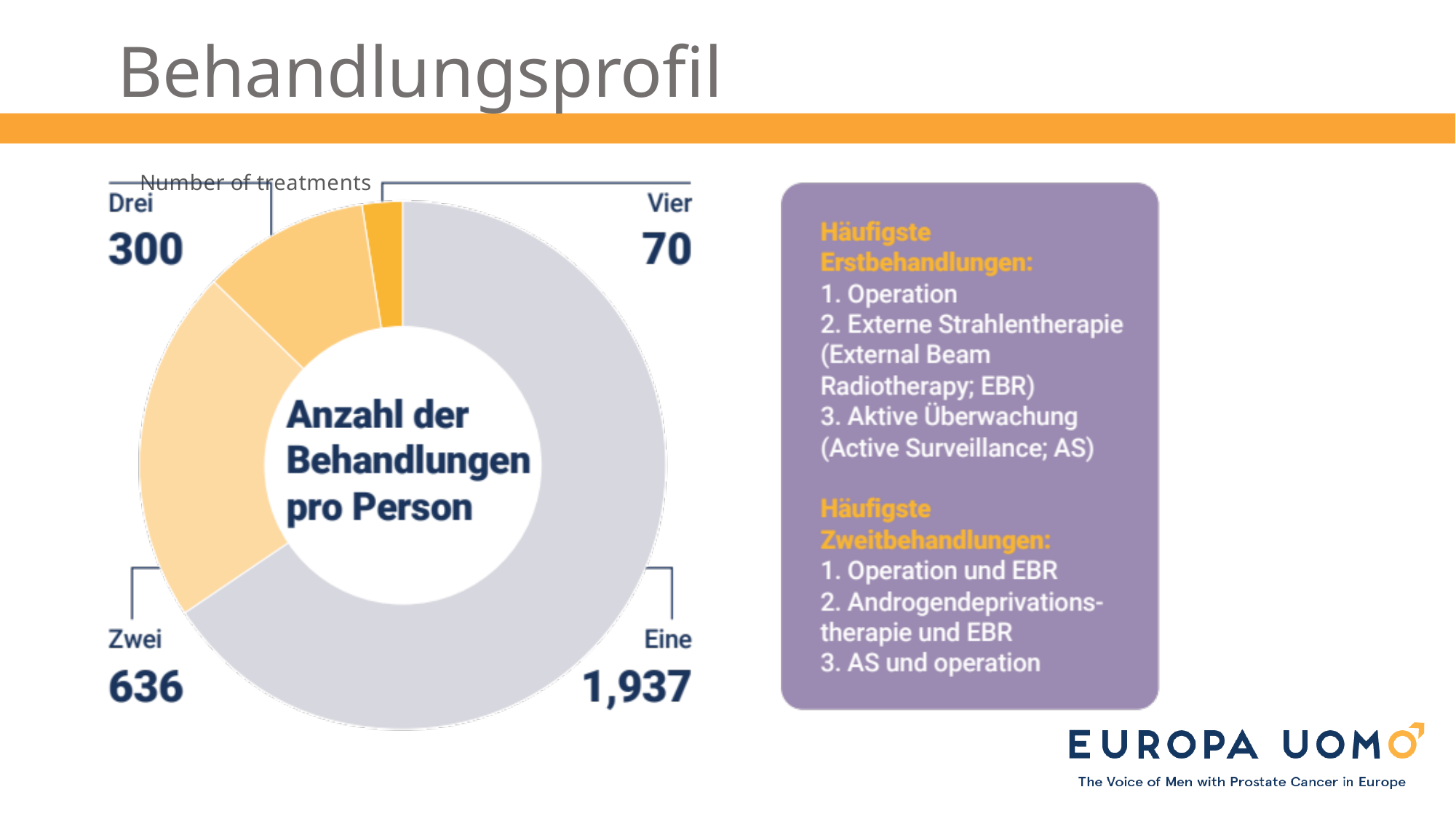
What is the value for "Drei" in the donut chart? 300 What kind of chart is shown on the slide? Pie (donut) chart Which is larger, the value for "Drei" or the value for "Vier"? Drei How many categories are shown in the donut chart? 4 What is the difference between the values for "Eine" and "Zwei"? 1,301 Which category has the smallest value in the donut chart? Vier What is the value for "Zwei" in the donut chart? 636 What is the total of all four values shown in the donut chart? 2,943 Which category has the largest value in the donut chart? Eine What is the value for "Vier" in the donut chart? 70 What is the value for "Eine" in the donut chart? 1,937 What is the difference between the values for "Zwei" and "Drei"? 336